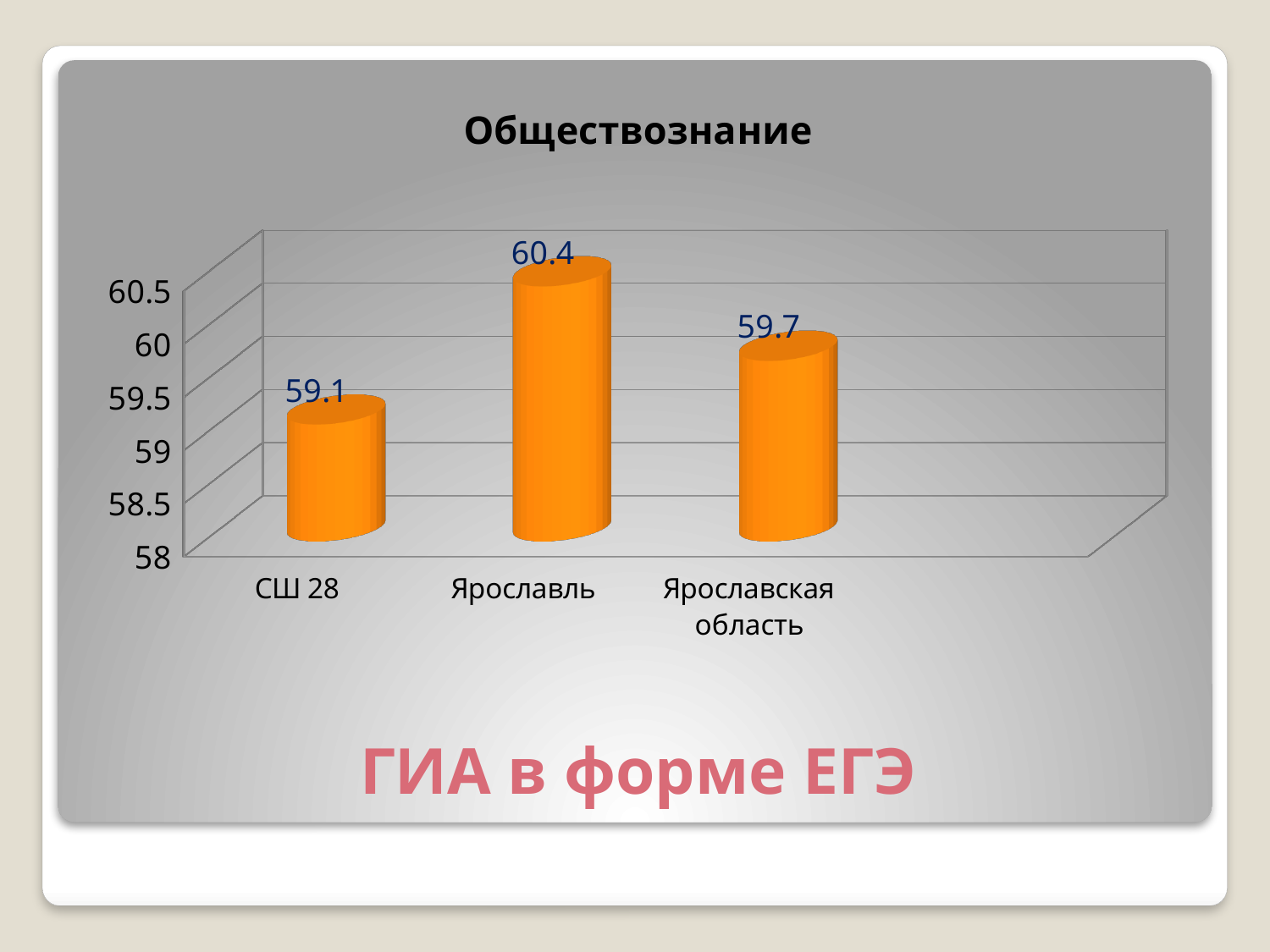
What is the title of the chart? Обществознание What is the value for СШ 28? 59.1 What is the difference between the values for Ярославль and СШ 28? 1.3 Which category has the lowest value? СШ 28 What is the value for Ярославль? 60.4 What is the difference between the values for Ярославская область and СШ 28? 0.6 What kind of chart is shown on the slide? bar chart Which is larger, the value for Ярославль or the value for Ярославская область? Ярославль Is the value for СШ 28 greater or less than 59.5? less What is the value for Ярославская область? 59.7 Which category has the highest value? Ярославль How many categories are shown on the chart? 3